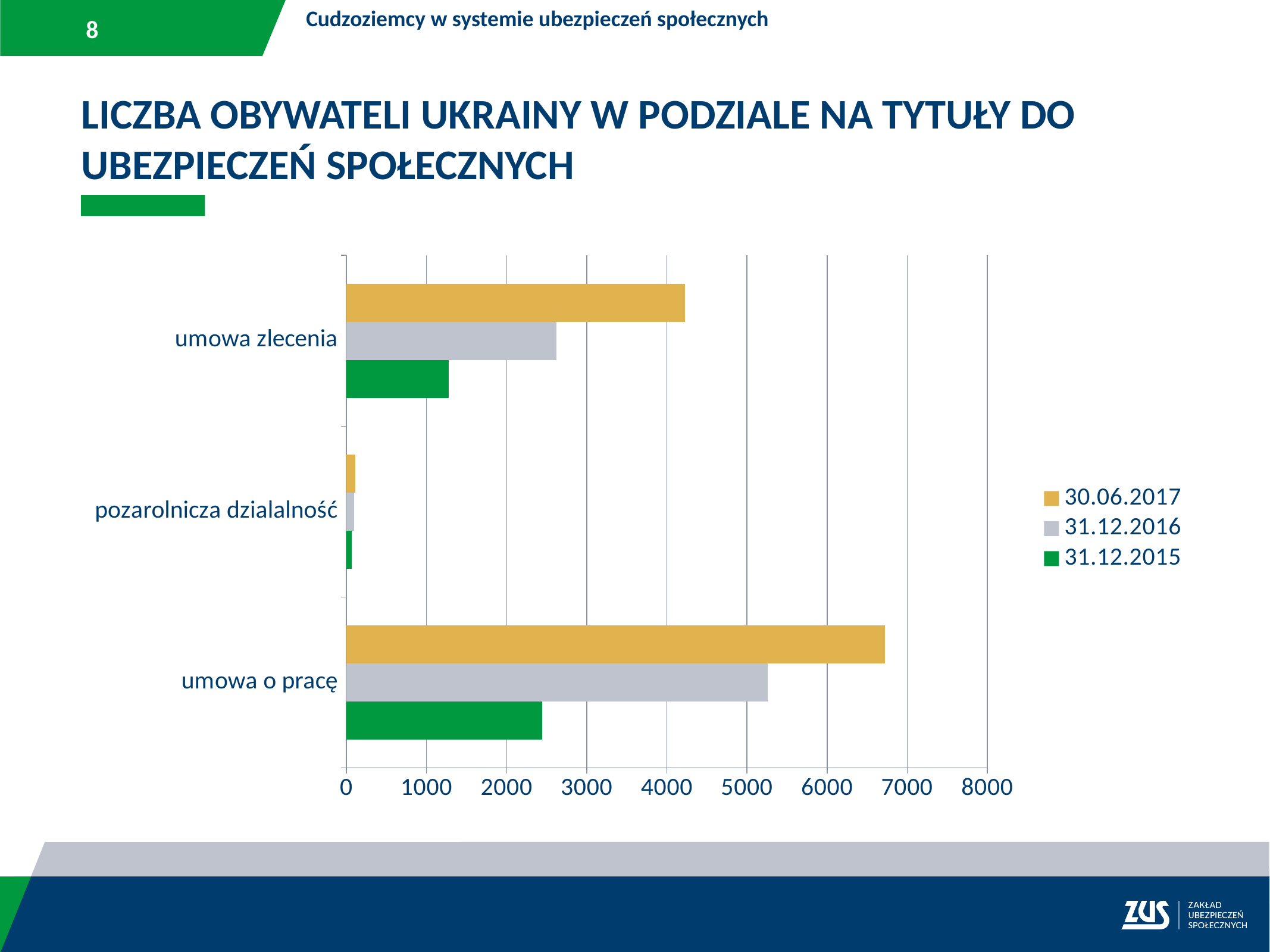
Is the value for umowa zlecenia in the 30.06.2017 series greater or less than 5000? less Which is larger: umowa o pracę for 31.12.2016 or umowa zlecenia for 30.06.2017? umowa o pracę for 31.12.2016 Is the value for umowa zlecenia in the 31.12.2016 series greater or less than 2000? greater How many series does the legend list? 3 What kind of chart is shown on the slide? bar chart How many categories are shown on the chart? 3 Is the value for umowa o pracę in the 31.12.2015 series greater or less than 3000? less Which colour represents the 31.12.2015 series in the legend? green For umowa o pracę, do the values rise or fall from 31.12.2015 to 30.06.2017? rise Which category has the lowest value for the 31.12.2016 series? pozarolnicza dzialalność Which category has the highest value for the 30.06.2017 series? umowa o pracę